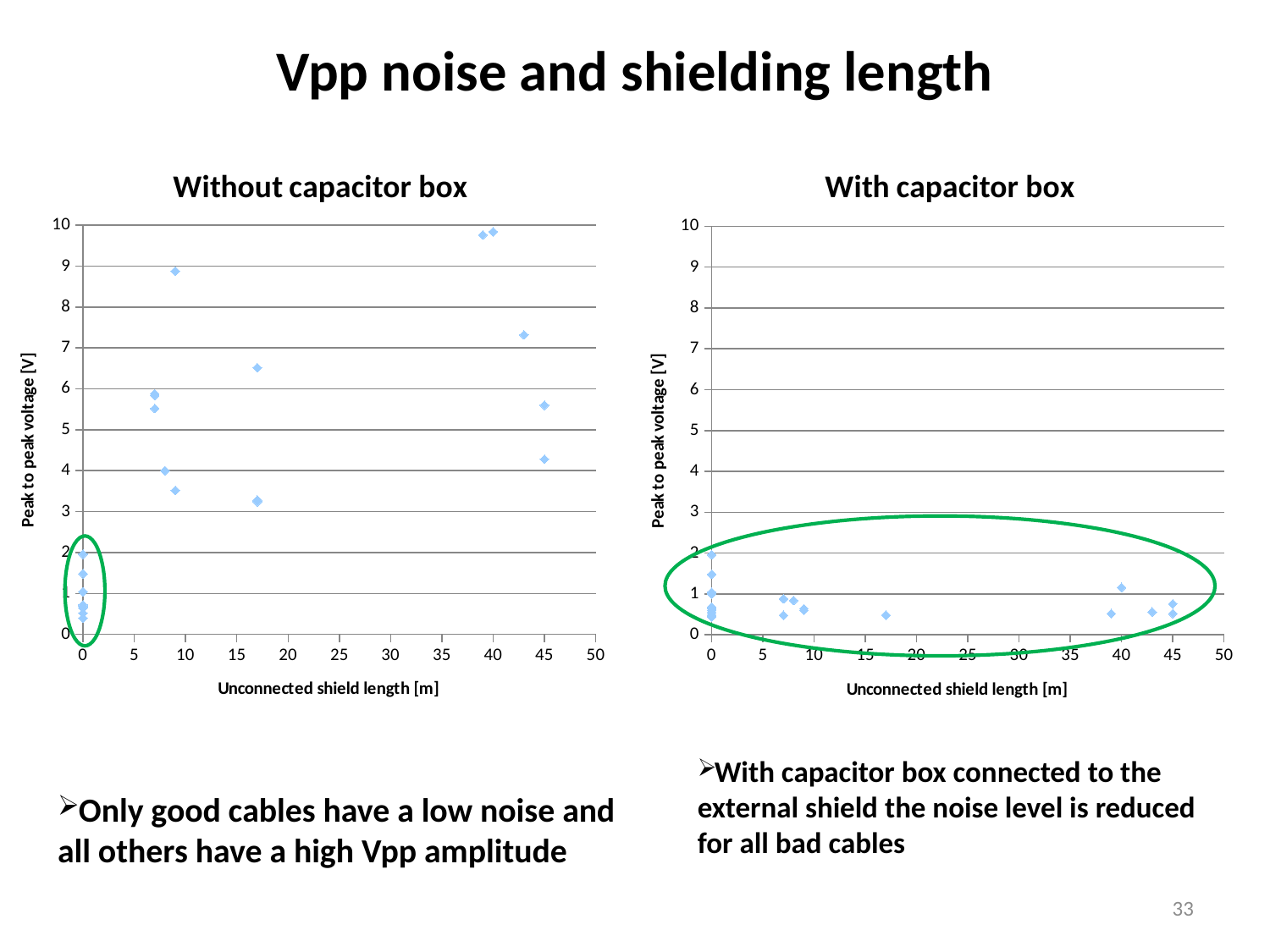
What is the x-axis title of the 'With capacitor box' chart? Unconnected shield length [m] What is the y-axis title of the 'Without capacitor box' chart? Peak to peak voltage [V] In the 'With capacitor box' chart, is the point at about 17 m shield length greater or less than 1 V? less In the 'Without capacitor box' chart, is the point at about 9 m shield length with the highest voltage greater or less than 8 V? greater What kind of chart is the 'With capacitor box' chart? scatter chart What is the maximum value shown on the y-axis of the 'With capacitor box' chart? 10 In the 'With capacitor box' chart, is the highest plotted point greater or less than 3 V? less What kind of chart is the 'Without capacitor box' chart? scatter chart Which chart has the higher maximum plotted peak to peak voltage, 'Without capacitor box' or 'With capacitor box'? Without capacitor box How many charts are shown on the slide? 2 In the 'Without capacitor box' chart, which has the higher peak to peak voltage: the points near 40 m or the point near 17 m with the highest voltage? the points near 40 m